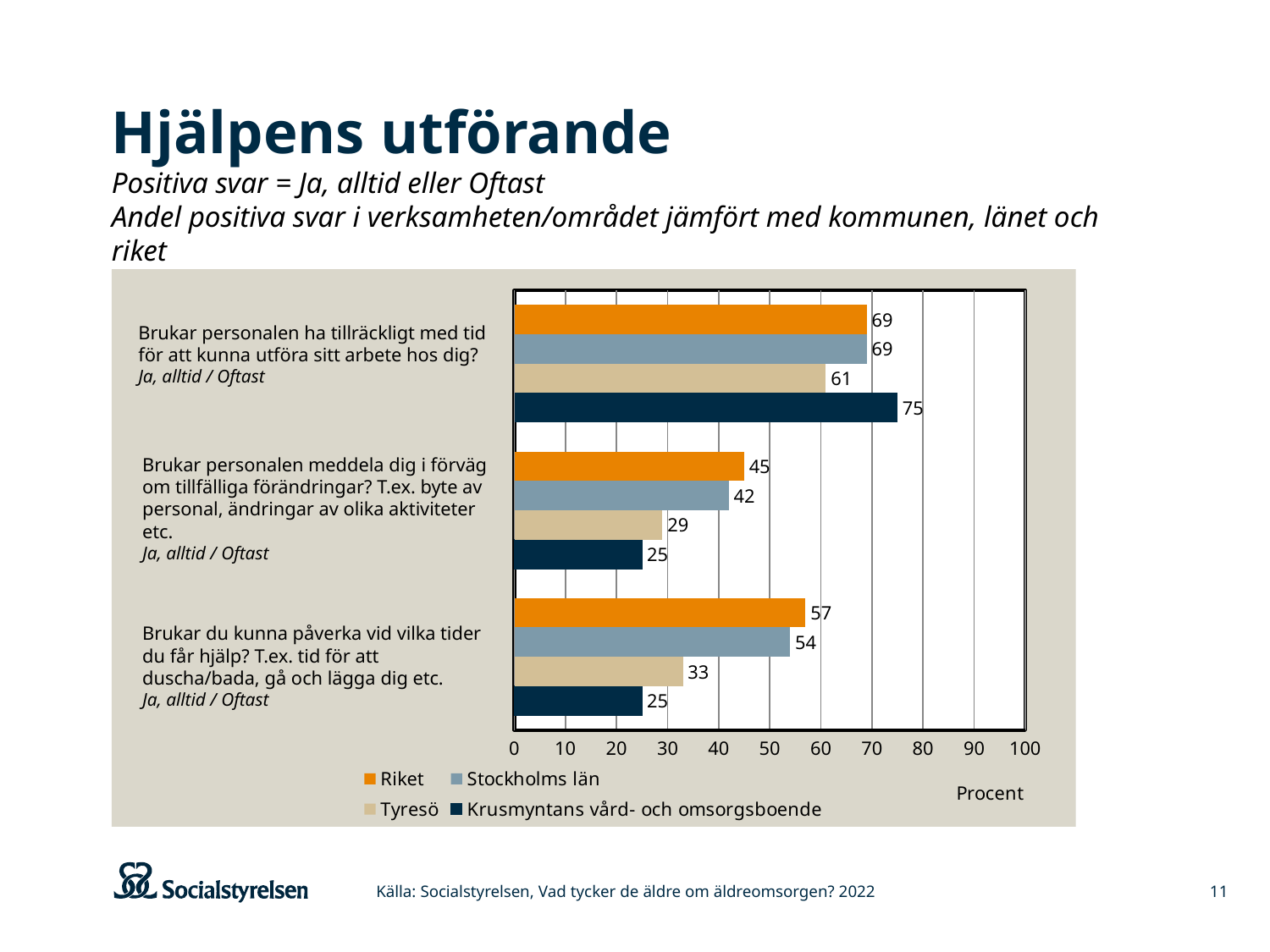
What kind of chart is shown on the slide? Bar chart Is the value for Tyresö for the question "Brukar personalen ha tillräckligt med tid för att kunna utföra sitt arbete hos dig?" greater or less than 50? greater What unit is shown on the horizontal axis of the chart? Procent What is the value for Tyresö for the question "Brukar du kunna påverka vid vilka tider du får hjälp?"? 33 Which series has the highest value for the question "Brukar personalen ha tillräckligt med tid för att kunna utföra sitt arbete hos dig?"? Krusmyntans vård- och omsorgsboende For the question "Brukar personalen meddela dig i förväg om tillfälliga förändringar?", which is larger: Riket or Tyresö? Riket How many questions (categories) are shown in the chart? 3 What is the difference between Riket and Krusmyntans vård- och omsorgsboende for the question "Brukar du kunna påverka vid vilka tider du får hjälp?"? 32 What is the value for Stockholms län for the question "Brukar personalen meddela dig i förväg om tillfälliga förändringar?"? 42 What is the value for Krusmyntans vård- och omsorgsboende for the question "Brukar personalen ha tillräckligt med tid för att kunna utföra sitt arbete hos dig?"? 75 How many series does the legend list? 4 Which series has the lowest value for the question "Brukar du kunna påverka vid vilka tider du får hjälp?"? Krusmyntans vård- och omsorgsboende